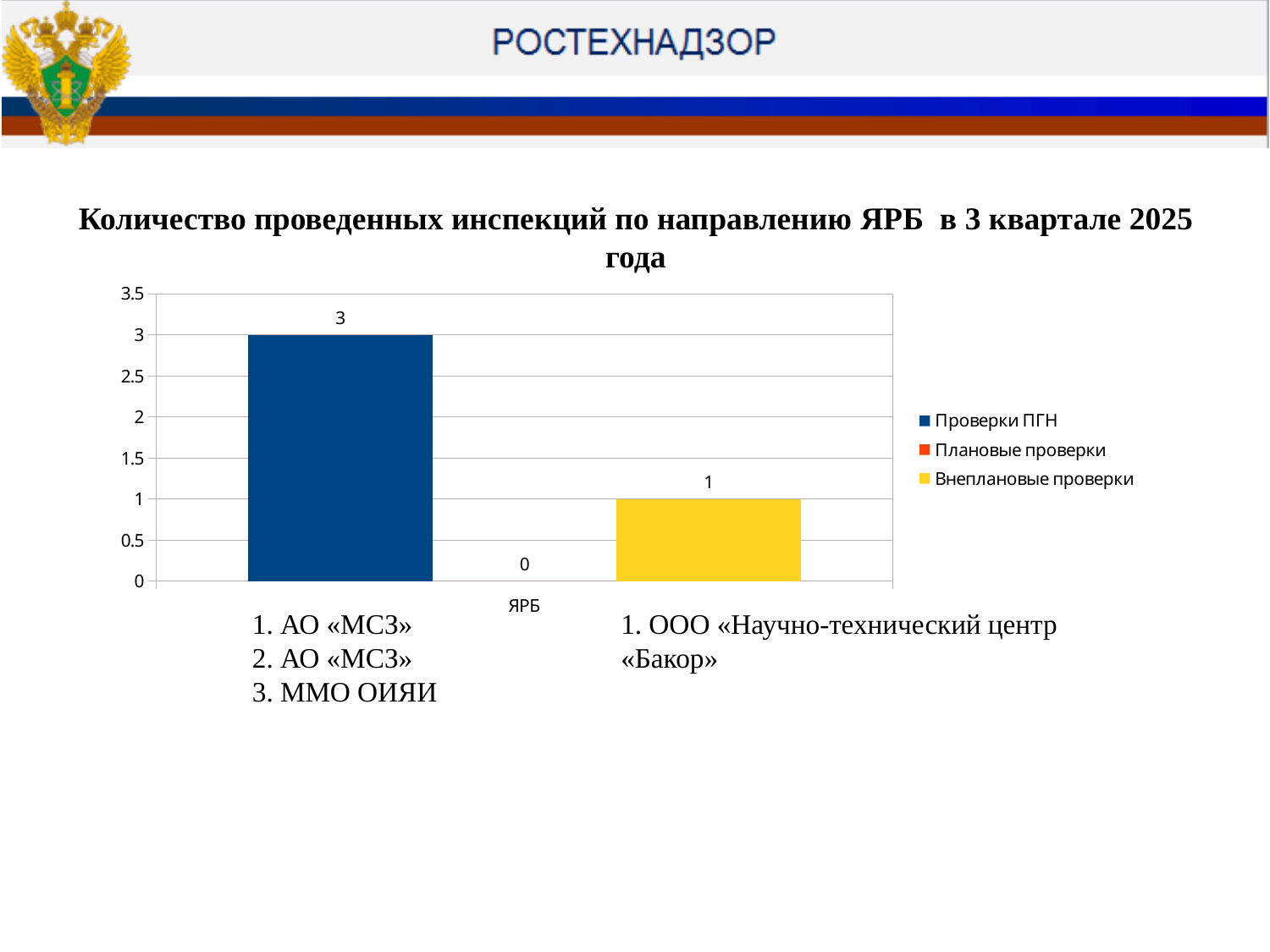
Which is larger for ЯРБ: Проверки ПГН or Внеплановые проверки? Проверки ПГН What is the value for Внеплановые проверки in the ЯРБ category? 1 How many categories are shown on the x axis? 1 Which series has the highest value in the ЯРБ category? Проверки ПГН What is the value for Плановые проверки in the ЯРБ category? 0 How many series does the legend list? 3 What is the difference between Проверки ПГН and Внеплановые проверки for ЯРБ? 2 Which series has the lowest value in the ЯРБ category? Плановые проверки What kind of chart is shown on the slide? bar chart Is the value for Проверки ПГН greater or less than 2? greater What is the value for Проверки ПГН in the ЯРБ category? 3 What colour represents Внеплановые проверки in the legend? yellow